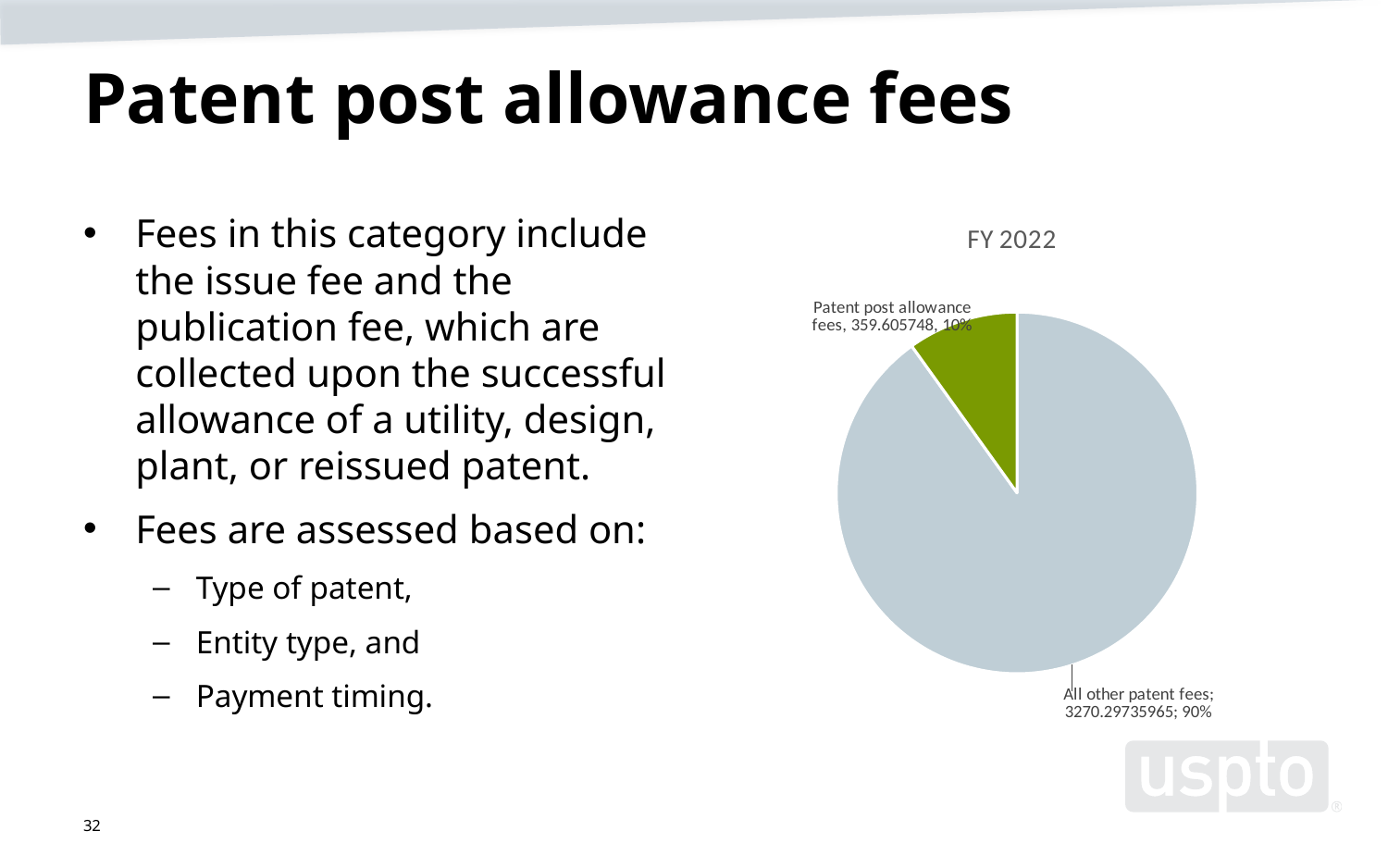
What share of the pie is All other patent fees? 90% What kind of chart is shown on the slide? Pie chart What colour is the Patent post allowance fees slice? Green Which slice is the largest? All other patent fees Which slice is the smallest? Patent post allowance fees What is the difference in percentage share between All other patent fees and Patent post allowance fees? 80% Which is larger, Patent post allowance fees or All other patent fees? All other patent fees What share of the pie is Patent post allowance fees? 10% What is the value shown for Patent post allowance fees? 359.605748 How many slices does the pie chart have? 2 What is the title of the chart? FY 2022 What is the value shown for All other patent fees? 3270.29735965